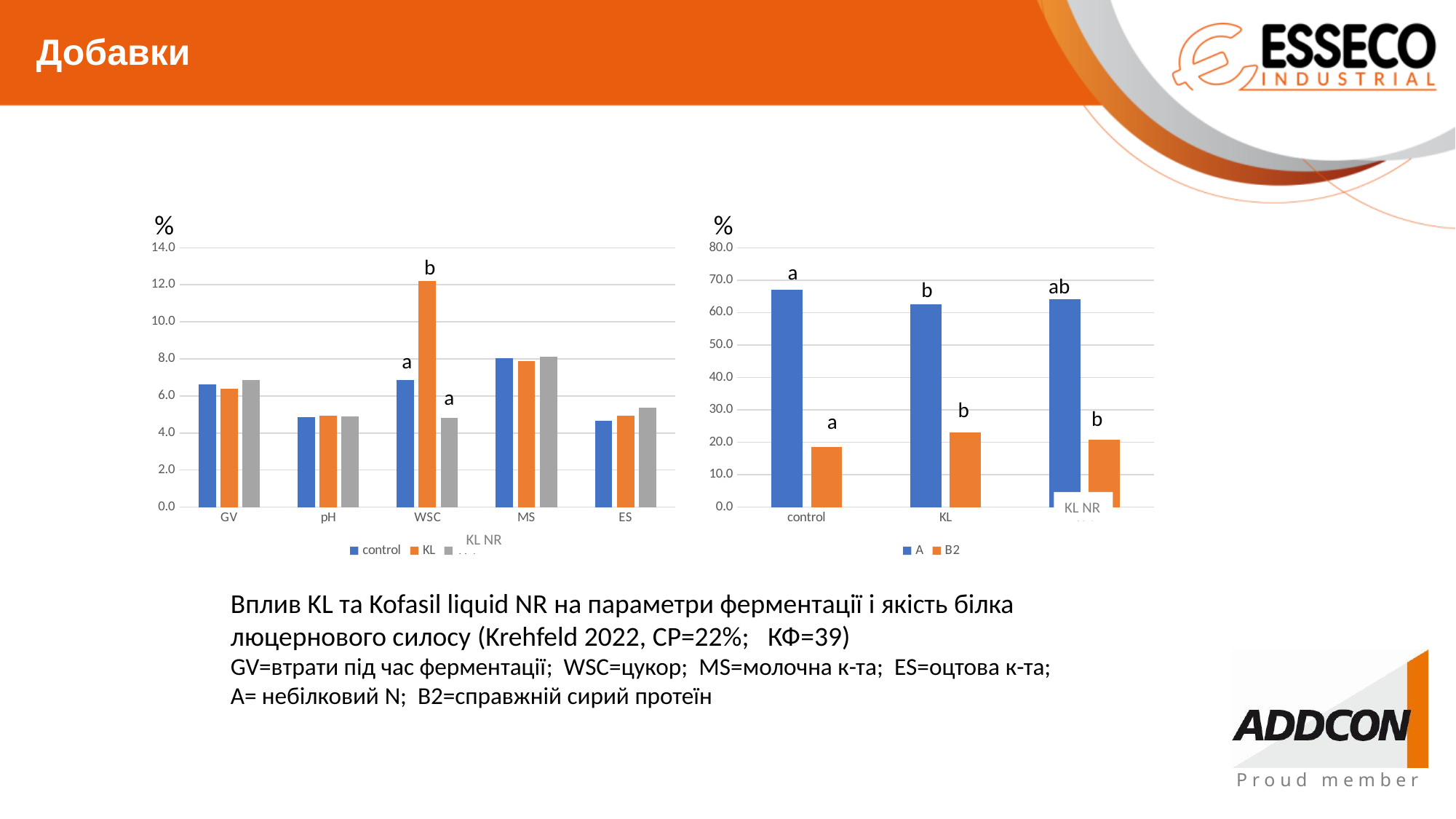
In the left chart, is the KL value for WSC greater or less than 10.0? greater In the left chart, which series has the highest value for WSC? KL In the right chart, which is larger for KL, the A value or the B2 value? A In the right chart, is the B2 value for KL greater or less than 20.0? greater How many series does the legend of the right chart list? 2 In the left chart, is the control value for pH greater or less than 6.0? less How many series does the legend of the left chart list? 3 In the left chart, which category has the highest KL value? WSC How many categories are shown on the x axis of the right chart? 3 How many categories are shown on the x axis of the left chart? 5 What kind of chart is the left chart? bar chart